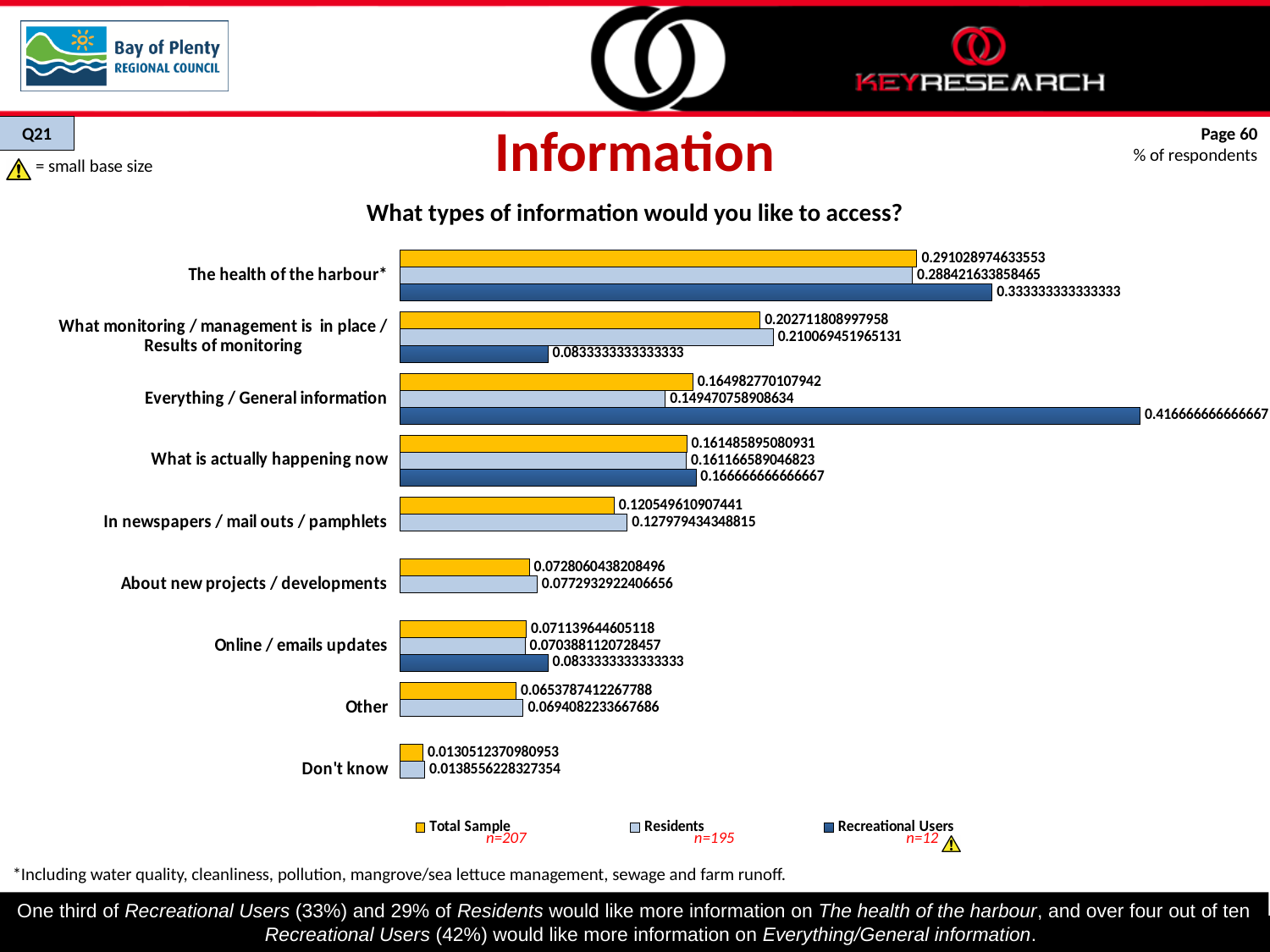
Which category has the highest Recreational Users value? Everything / General information How many categories are shown on the chart? 9 What kind of chart is shown on the slide? Bar chart What is the Recreational Users value for 'Everything / General information'? 0.416666666666667 What is the Total Sample value for 'The health of the harbour*'? 0.291028974633553 What is the Residents value for 'What monitoring / management is in place / Results of monitoring'? 0.210069451965131 For 'Everything / General information', which is larger: the Recreational Users value or the Total Sample value? Recreational Users How many series does the legend list? 3 Which category has the lowest Total Sample value? Don't know What is the Residents value for 'Don't know'? 0.0138556228327354 What is the difference between the Recreational Users values for 'The health of the harbour*' and 'What monitoring / management is in place / Results of monitoring'? 0.25 Which category has the highest Total Sample value? The health of the harbour*